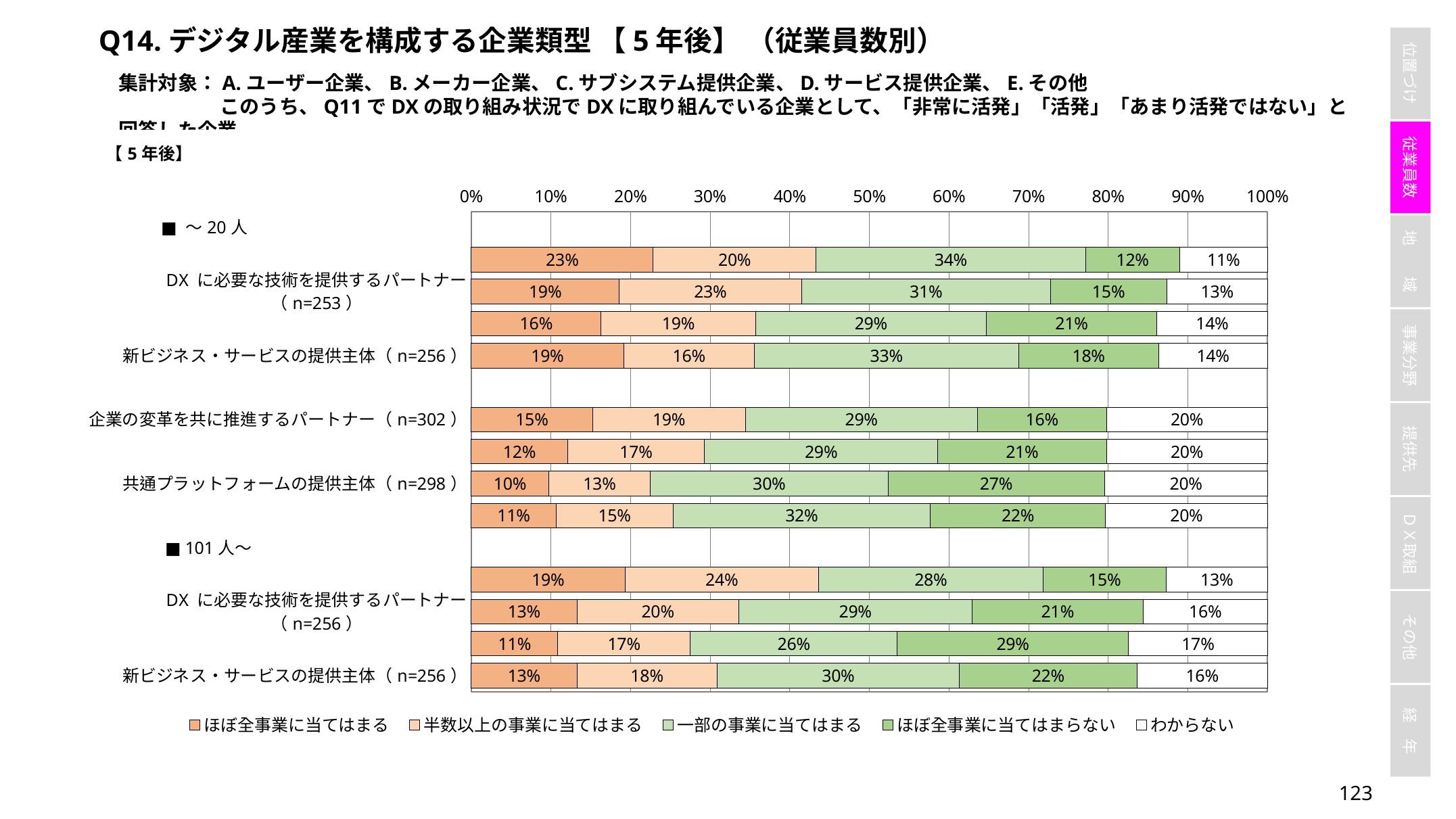
What is the value of ほぼ全事業に当てはまる for 企業の変革を共に推進するパートナー (n=302)? 15% What is the value of わからない for 企業の変革を共に推進するパートナー (n=302)? 20% Which series has the largest segment in the bar for 企業の変革を共に推進するパートナー (n=302)? 一部の事業に当てはまる What is the first legend entry (the darkest orange series)? ほぼ全事業に当てはまる What kind of chart is shown on the slide? Stacked bar chart What is the value of ほぼ全事業に当てはまらない for 共通プラットフォームの提供主体 (n=298)? 27% For 企業の変革を共に推進するパートナー (n=302), what is the difference between わからない and ほぼ全事業に当てはまる? 5 percentage points In the 101人～ group, what is the value of 半数以上の事業に当てはまる for DXに必要な技術を提供するパートナー (n=256)? 20% Which series has the smallest segment in the bar for 企業の変革を共に推進するパートナー (n=302)? ほぼ全事業に当てはまる For 共通プラットフォームの提供主体 (n=298), which is larger: 一部の事業に当てはまる or ほぼ全事業に当てはまらない? 一部の事業に当てはまる How many series does the legend list? 5 In the 101人～ group, what is the value of 一部の事業に当てはまる for 新ビジネス・サービスの提供主体 (n=256)? 30%